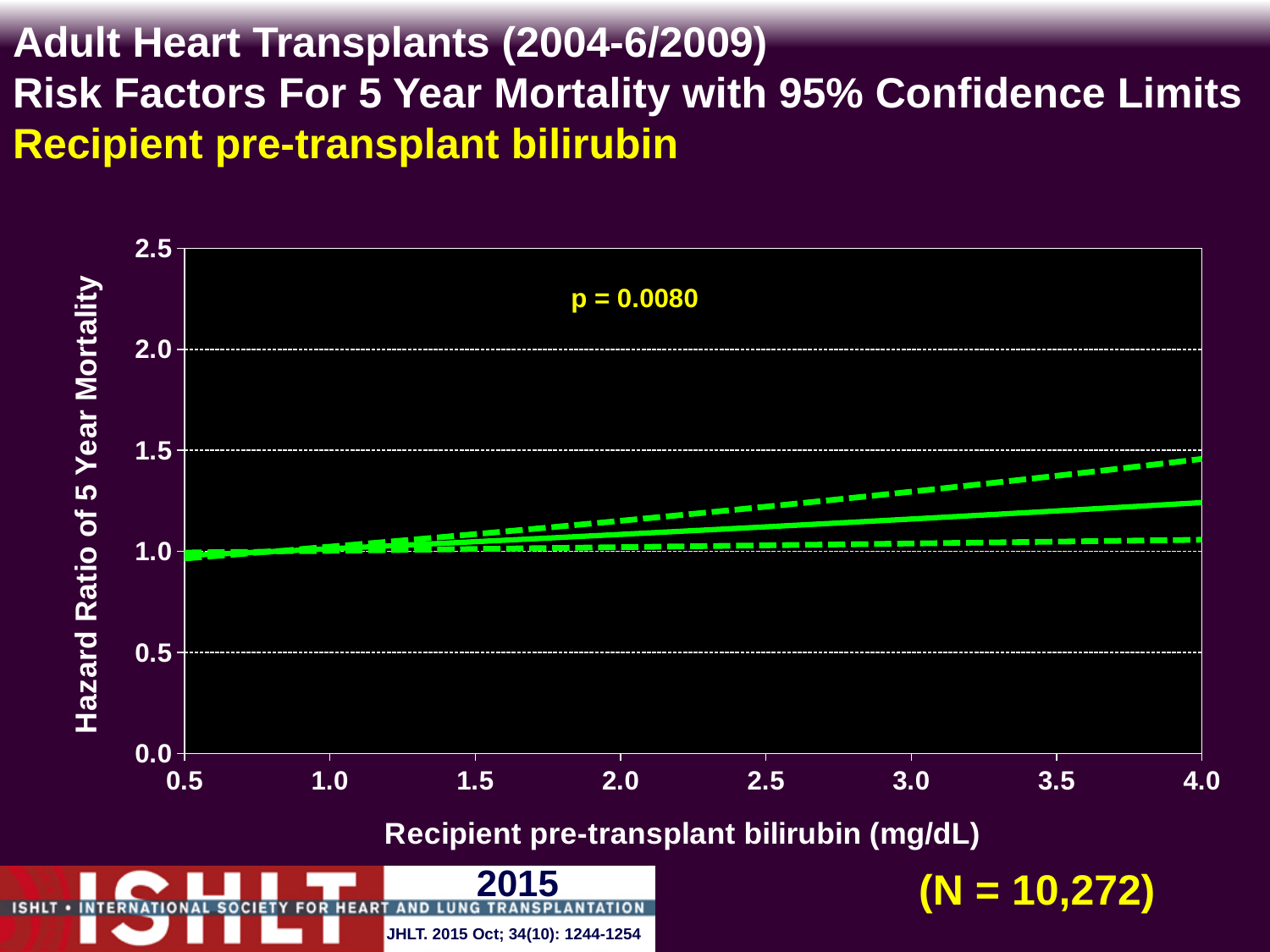
Is the upper 95% confidence limit (upper dashed line) at a bilirubin of 4.0 mg/dL greater or less than 1.0? greater At which bilirubin value on the x axis is the hazard ratio (solid line) highest? 4.0 Is the lower 95% confidence limit (lower dashed line) at a bilirubin of 4.0 mg/dL greater or less than 1.5? less Is the hazard ratio (solid line) at a bilirubin of 4.0 mg/dL greater or less than 1.0? greater Does the hazard ratio of 5 year mortality rise or fall as recipient pre-transplant bilirubin increases from 0.5 to 4.0 mg/dL? rise What kind of chart is shown on the slide? line chart What is the sample size (N) shown on the slide? N = 10,272 At which bilirubin value on the x axis is the hazard ratio (solid line) lowest? 0.5 What is the p-value shown on the chart? p = 0.0080 How many lines are plotted on the chart? 3